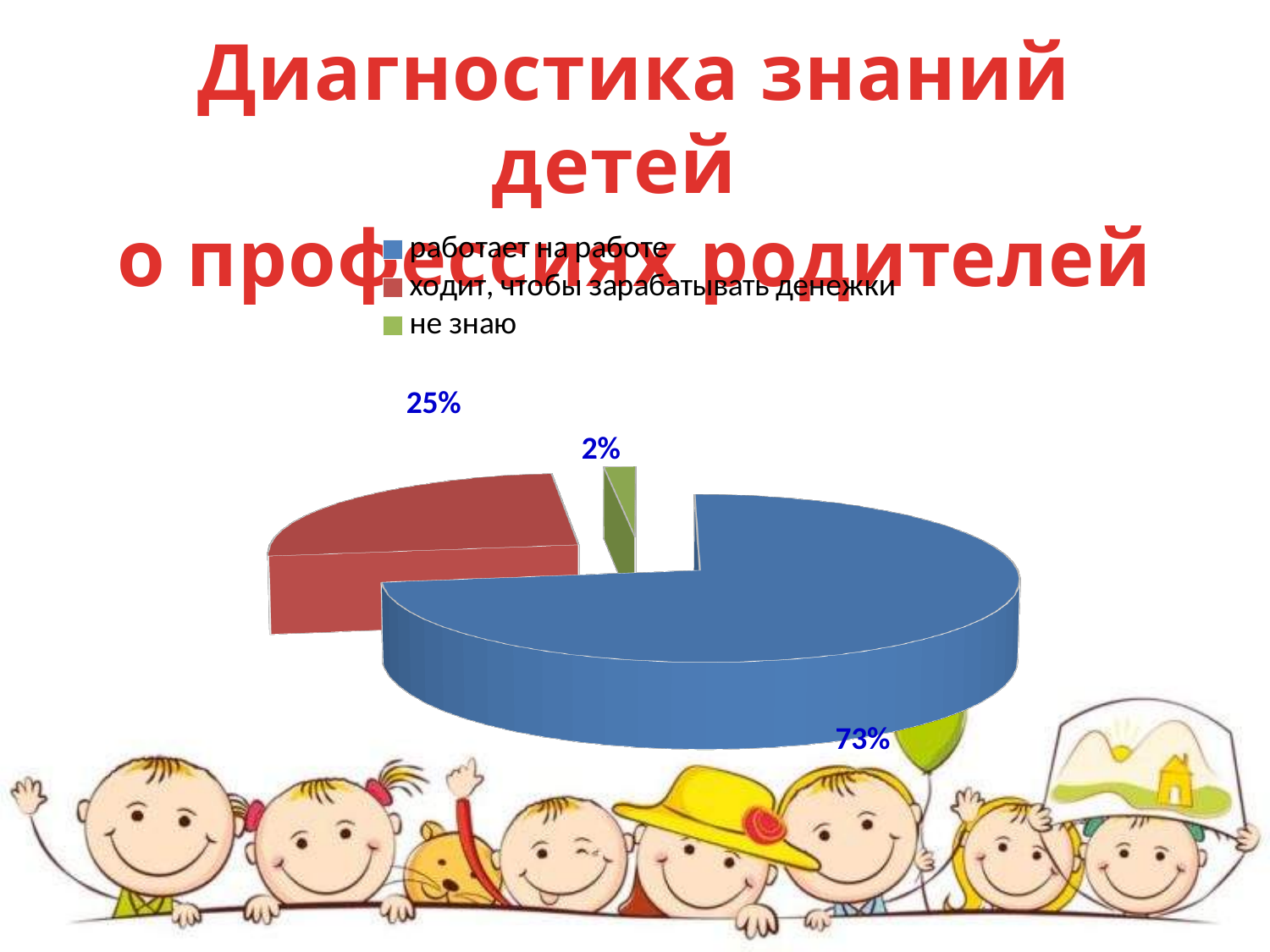
What colour is the slice for "не знаю"? green What is the difference in percentage points between the "работает на работе" slice and the "ходит, чтобы зарабатывать денежки" slice? 48 Which slice is larger: "ходит, чтобы зарабатывать денежки" or "не знаю"? ходит, чтобы зарабатывать денежки Which category has the largest slice of the pie? работает на работе What kind of chart is shown on the slide? pie chart What percentage of the pie is the slice for "ходит, чтобы зарабатывать денежки"? 25% How many entries does the legend list? 3 How many slices does the pie chart have? 3 What colour is the slice for "работает на работе"? blue What percentage of the pie is the slice for "работает на работе"? 73% What percentage of the pie is the slice for "не знаю"? 2% Which category has the smallest slice of the pie? не знаю